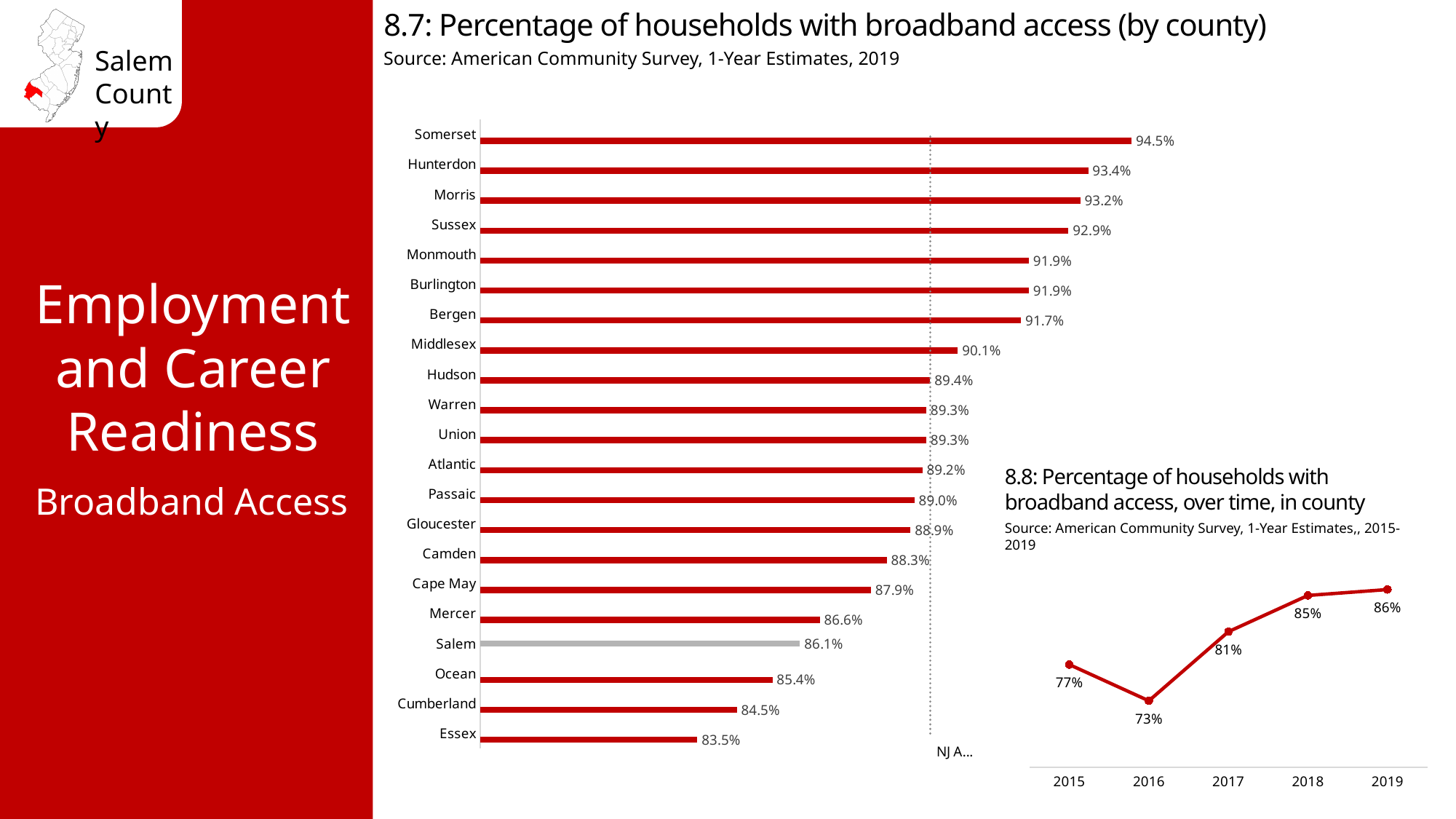
In chart 8.7 (Percentage of households with broadband access by county), what is the value for Salem? 86.1% In chart 8.7 (Percentage of households with broadband access by county), what is the value for Cumberland? 84.5% In chart 8.7 (Percentage of households with broadband access by county), which is larger, the value for Mercer or the value for Ocean? Mercer In chart 8.8 (Percentage of households with broadband access over time in county), what is the value for 2016? 73% In chart 8.7 (Percentage of households with broadband access by county), which county has the highest value? Somerset In chart 8.8 (Percentage of households with broadband access over time in county), which year has the highest value? 2019 In chart 8.7 (Percentage of households with broadband access by county), what is the difference between Somerset and Essex? 11.0% In chart 8.7 (Percentage of households with broadband access by county), which county has the lowest value? Essex In chart 8.8 (Percentage of households with broadband access over time in county), what is the difference between 2019 and 2015? 9% What kind of chart is chart 8.8 (Percentage of households with broadband access over time in county)? Line chart In chart 8.7 (Percentage of households with broadband access by county), how many counties are shown? 21 What kind of chart is chart 8.7 (Percentage of households with broadband access by county)? Bar chart